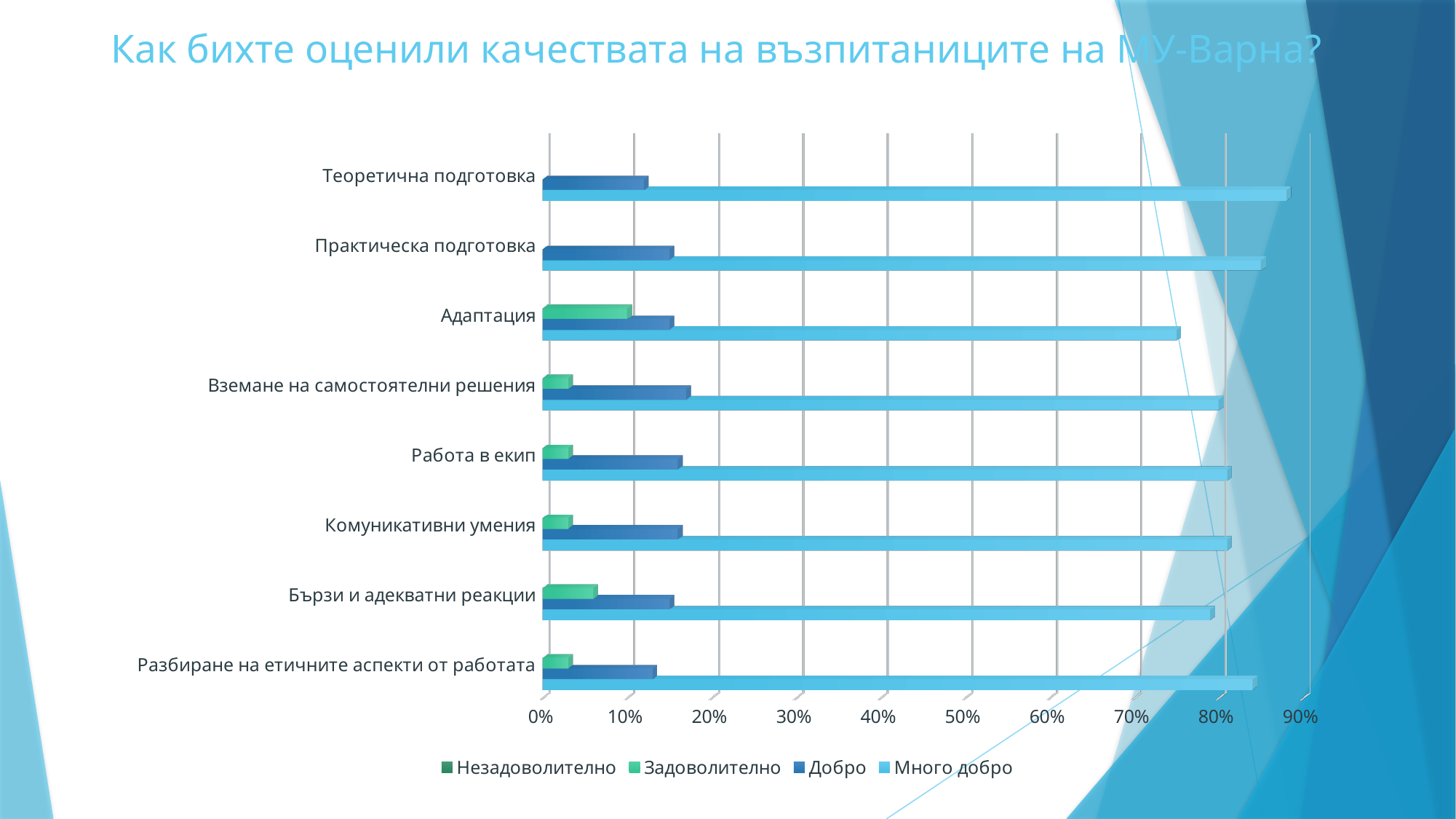
Which series is listed first in the chart legend? Незадоволително Which category has the lowest value for the 'Много добро' series? Адаптация How many categories (qualities) are listed on the vertical axis of the chart? 8 Is the 'Добро' value for 'Теоретична подготовка' greater or less than 20%? less What kind of chart is shown on the slide? bar chart Which has the larger 'Добро' value: 'Вземане на самостоятелни решения' or 'Теоретична подготовка'? Вземане на самостоятелни решения Is the 'Много добро' value for 'Адаптация' greater or less than 80%? less Is the 'Задоволително' value for 'Бързи и адекватни реакции' greater or less than 10%? less Which category has the highest value for the 'Много добро' series? Теоретична подготовка What is the title of the slide? Как бихте оценили качествата на възпитаниците на МУ-Варна? How many series does the chart legend list? 4